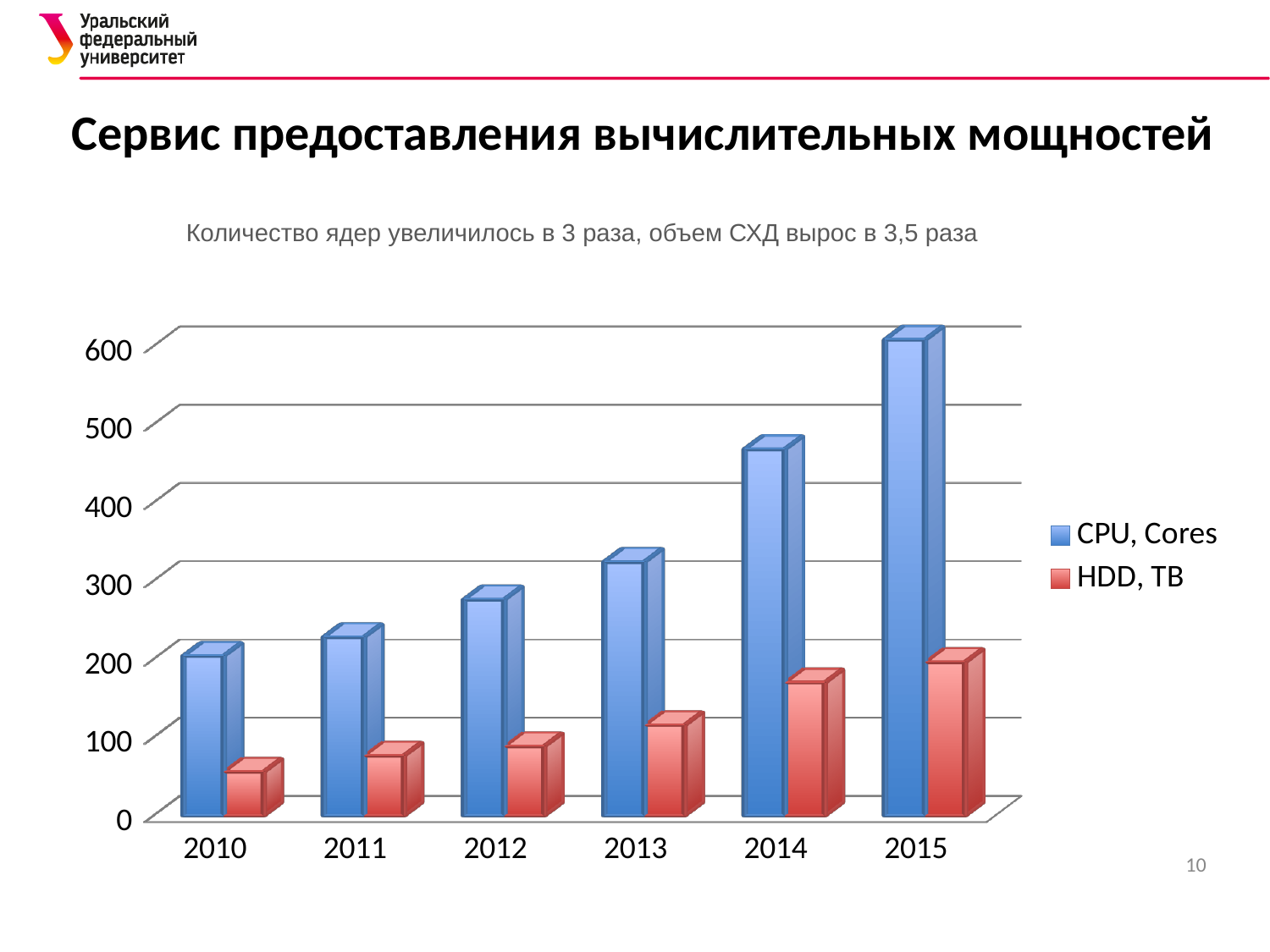
How many series does the legend list? 2 How many years are shown on the x axis of the chart? 6 Which year has the highest value for CPU, Cores? 2015 Which year has the lowest value for HDD, TB? 2010 What kind of chart is shown on the slide? bar chart Do the CPU, Cores values rise or fall from 2010 to 2015? rise Is the value for CPU, Cores in 2014 greater or less than 400? greater Is the value for HDD, TB in 2010 greater or less than 100? less Is the value for CPU, Cores in 2010 greater or less than 300? less Which colour represents the HDD, TB series in the chart? red In 2013, which series has the larger value, CPU, Cores or HDD, TB? CPU, Cores